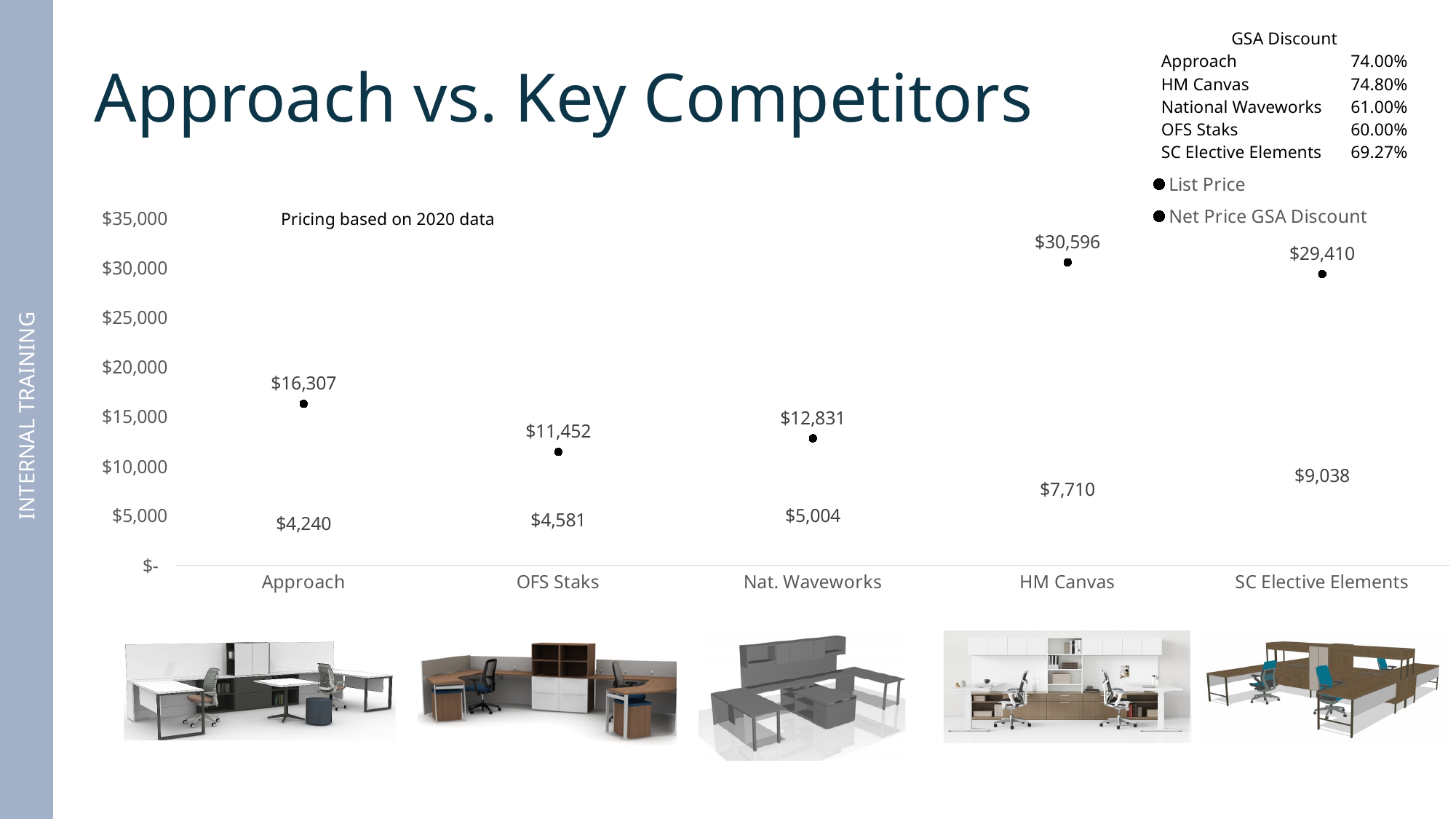
Which has a higher List Price, Nat. Waveworks or OFS Staks? Nat. Waveworks What is the difference between the List Price and the Net Price GSA Discount for Approach? $12,067 What is the List Price for HM Canvas? $30,596 How many series does the chart legend list? 2 What is the List Price for OFS Staks? $11,452 What is the Net Price GSA Discount value for Approach? $4,240 What is the Net Price GSA Discount value for SC Elective Elements? $9,038 What kind of chart is shown on the slide? Scatter (dot) chart Which product has the lowest Net Price GSA Discount value? Approach What year is the pricing in the chart based on, according to the note on the chart? 2020 How many products are shown on the x axis of the chart? 5 Which product has the highest List Price? HM Canvas